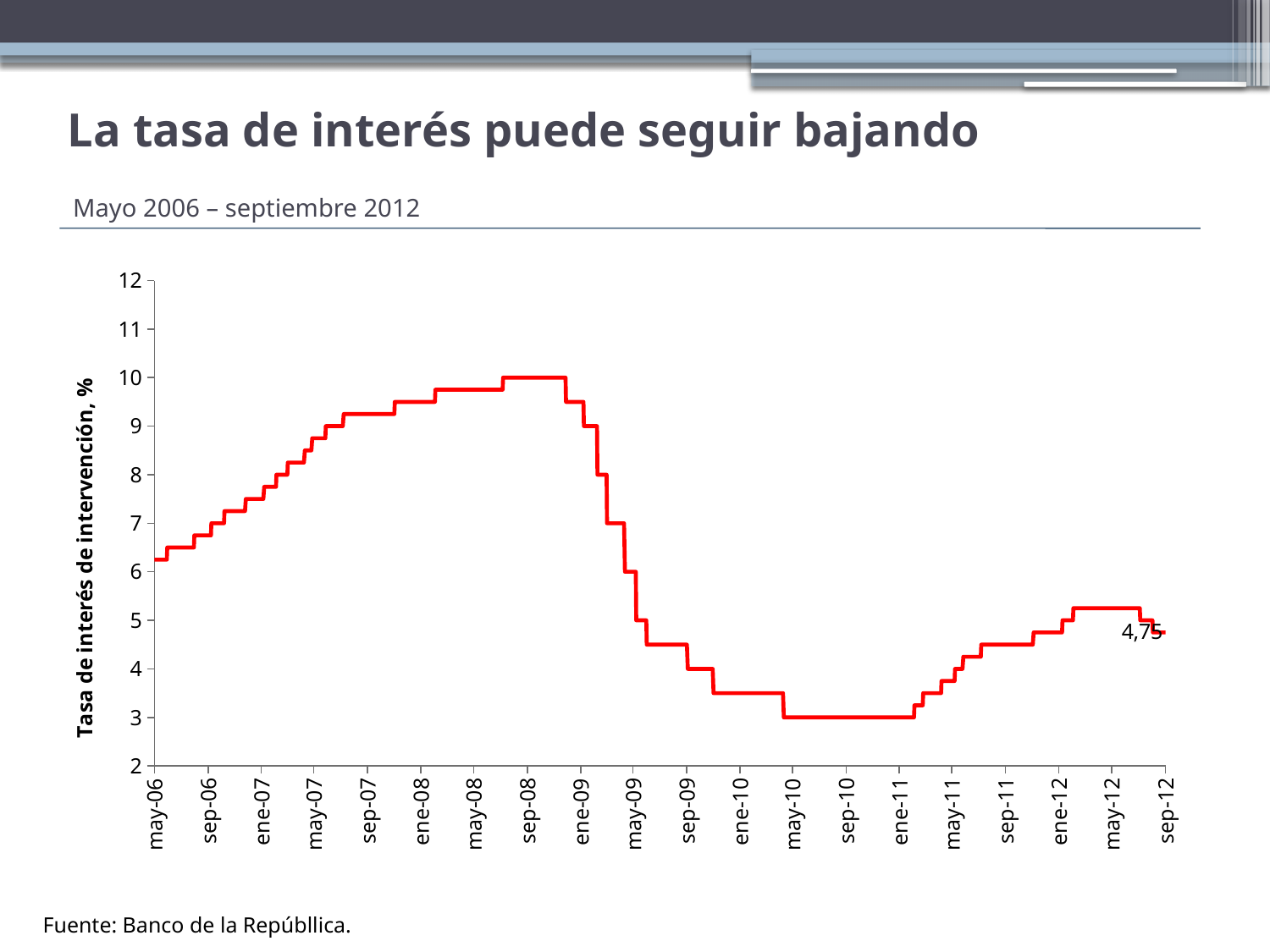
Is the value at sep-09 greater or less than 5? less Is the value at may-10 greater or less than 4? less Is the value at ene-08 greater or less than 9? greater What is the value of the intervention interest rate at sep-12, as labelled on the chart? 4,75 Does the line rise or fall between may-06 and sep-08? rise What value does the line reach at sep-08? 10 Which is larger, the value at may-07 or the value at may-09? may-07 What type of chart is shown on the slide? line chart What is the title of the vertical axis? Tasa de interés de intervención, % Around which x-axis label does the line reach its highest level? sep-08 Does the line rise or fall between ene-09 and may-10? fall